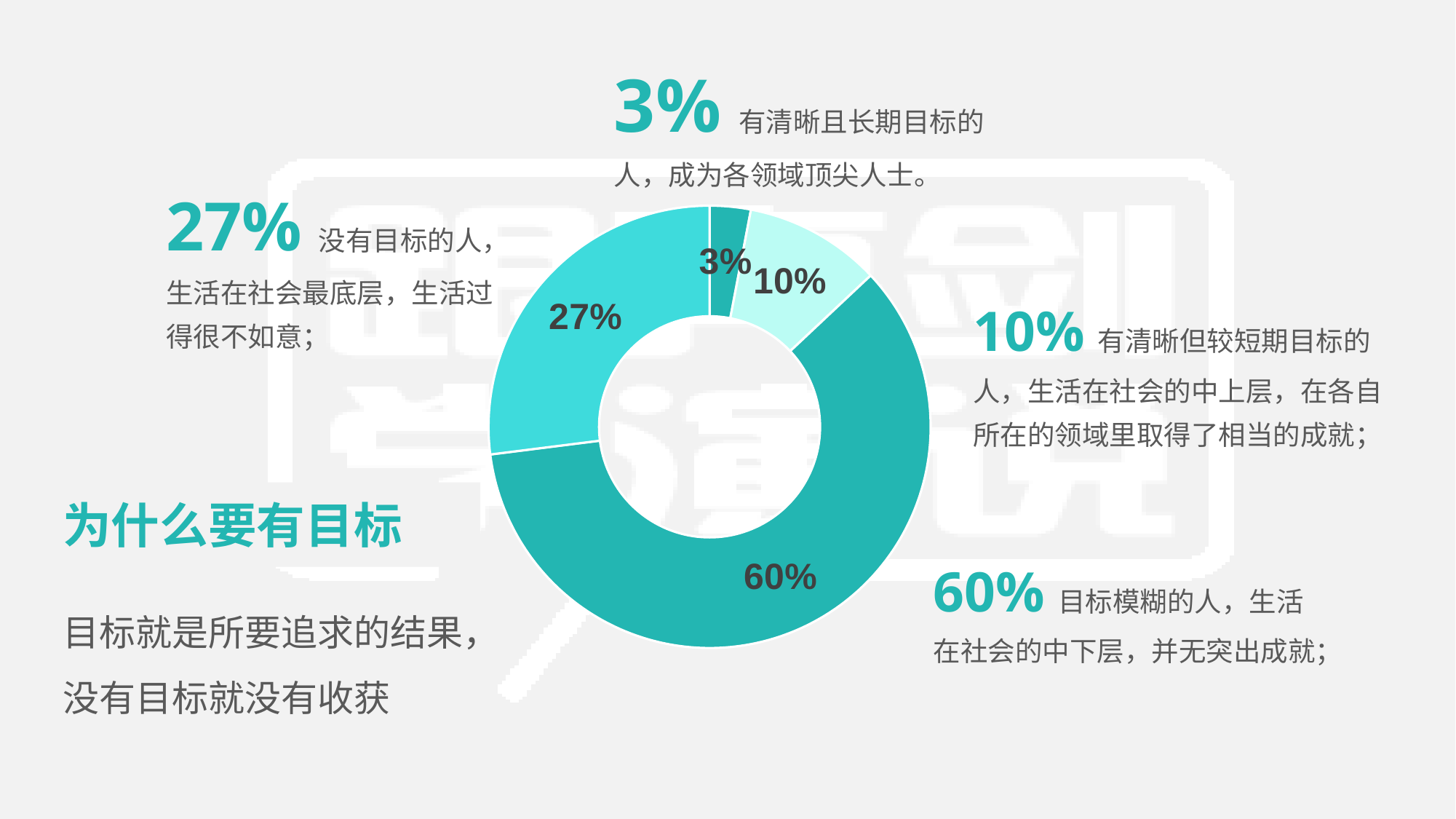
How many slices does the donut chart have? 4 What is the difference in percentage points between the 60% slice and the 27% slice? 33 Which group is larger in the donut chart: people with no goals (27%) or people with short-term goals (10%)? People with no goals (27%) According to the slide, what share of people have no goals (没有目标的人)? 27% According to the slide, what share of people have clear but short-term goals (有清晰但较短期目标的人)? 10% According to the slide, what share of people have clear, long-term goals (有清晰且长期目标的人)? 3% What do the four slices of the donut chart add up to? 100% What is the heading text in teal on the left side of the slide? 为什么要有目标 What percentage is shown for the largest slice of the donut chart? 60% According to the slide, what share of people have vague goals (目标模糊的人)? 60% What percentage is shown for the smallest slice of the donut chart? 3% What kind of chart is shown on the slide? Pie chart (donut)